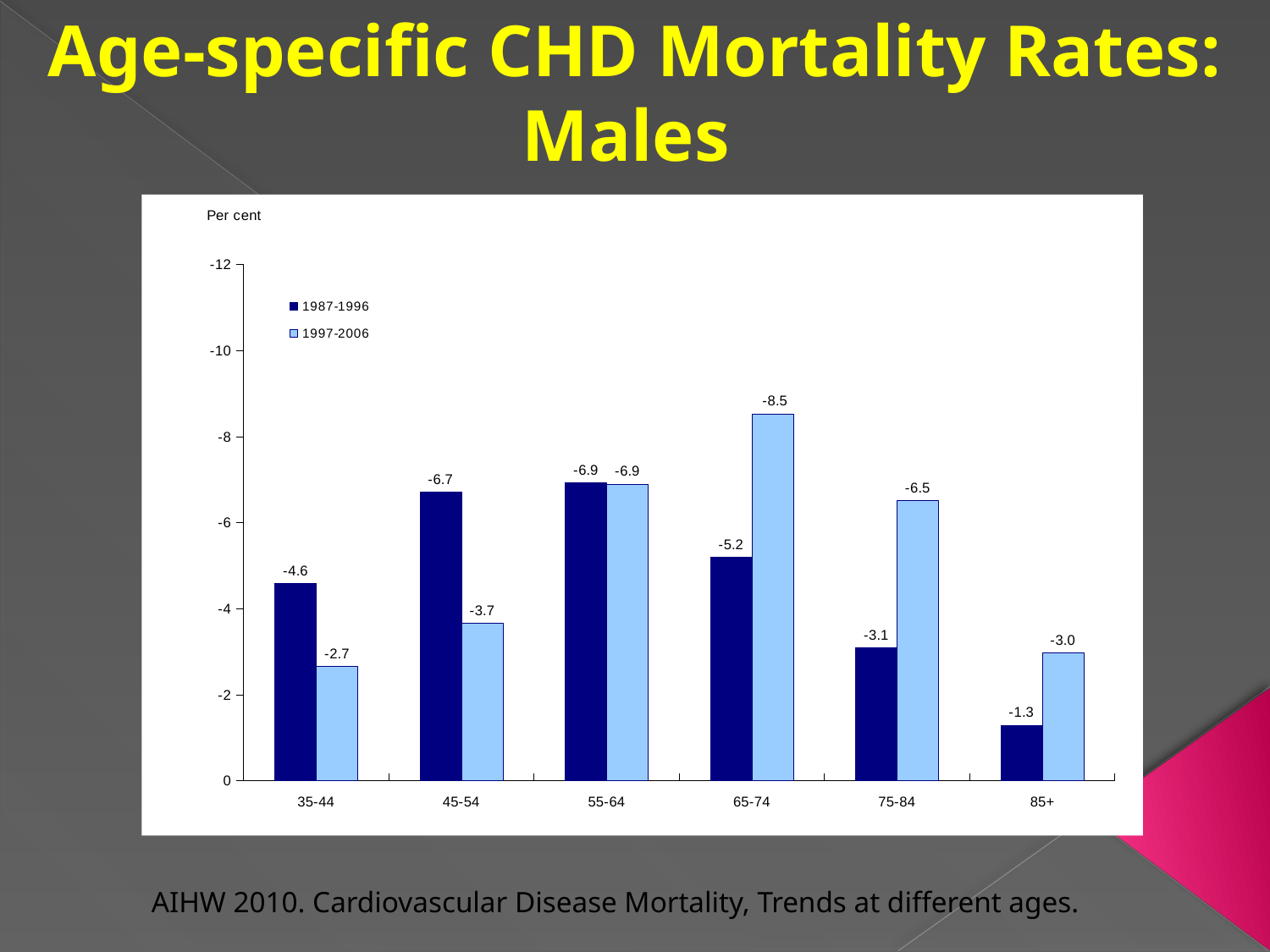
What is the value for the 65-74 age group in the 1997-2006 series? -8.5 What kind of chart is shown on the slide? Bar chart For the 75-84 age group, which series has the taller bar, 1987-1996 or 1997-2006? 1997-2006 What label is shown at the top of the vertical axis? Per cent How many age groups are shown on the x axis? 6 How many series does the legend list? 2 For the 65-74 age group, what is the difference between the 1997-2006 value (-8.5) and the 1987-1996 value (-5.2)? 3.3 Which age group has the shortest bar (value closest to zero) in the 1987-1996 series? 85+ What is the value for the 85+ age group in the 1987-1996 series? -1.3 What is the value for the 75-84 age group in the 1997-2006 series? -6.5 Which age group has the tallest bar (most negative value) in the 1997-2006 series? 65-74 What is the value for the 35-44 age group in the 1987-1996 series? -4.6